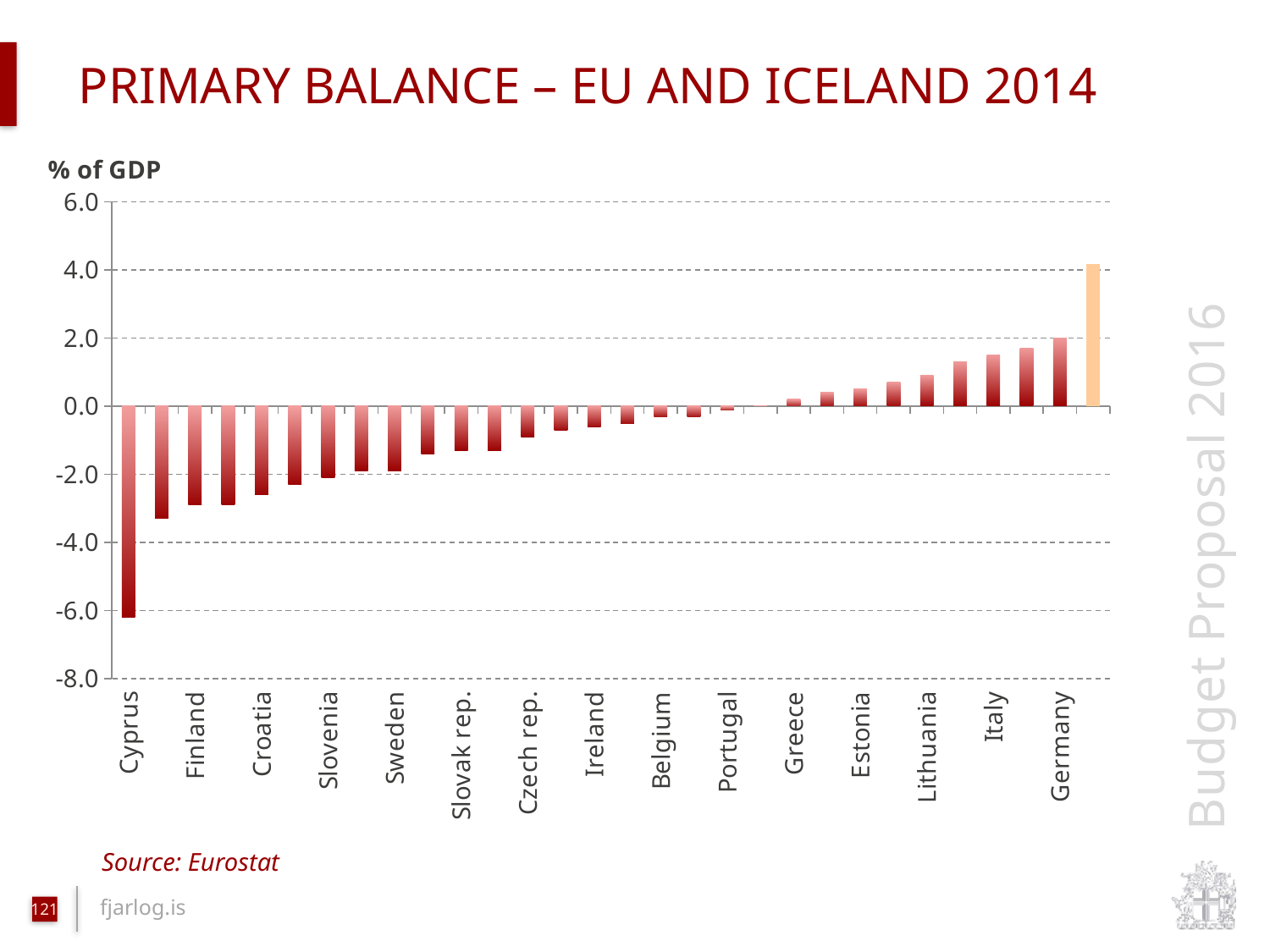
Among the countries labelled on the x axis, which has the highest primary balance? Germany What kind of chart is shown on the slide? bar chart Is the value for Italy greater or less than 1.0? greater Which has the larger primary balance, Italy or Lithuania? Italy Is the value for Lithuania greater or less than 2.0? less Is the value for Finland greater or less than -2.0? less Which has the larger primary balance, Cyprus or Finland? Finland What unit is shown on the y axis of the chart? % of GDP Which labelled country has the lowest primary balance in the chart? Cyprus Do the values rise or fall moving from left to right along the x axis? rise